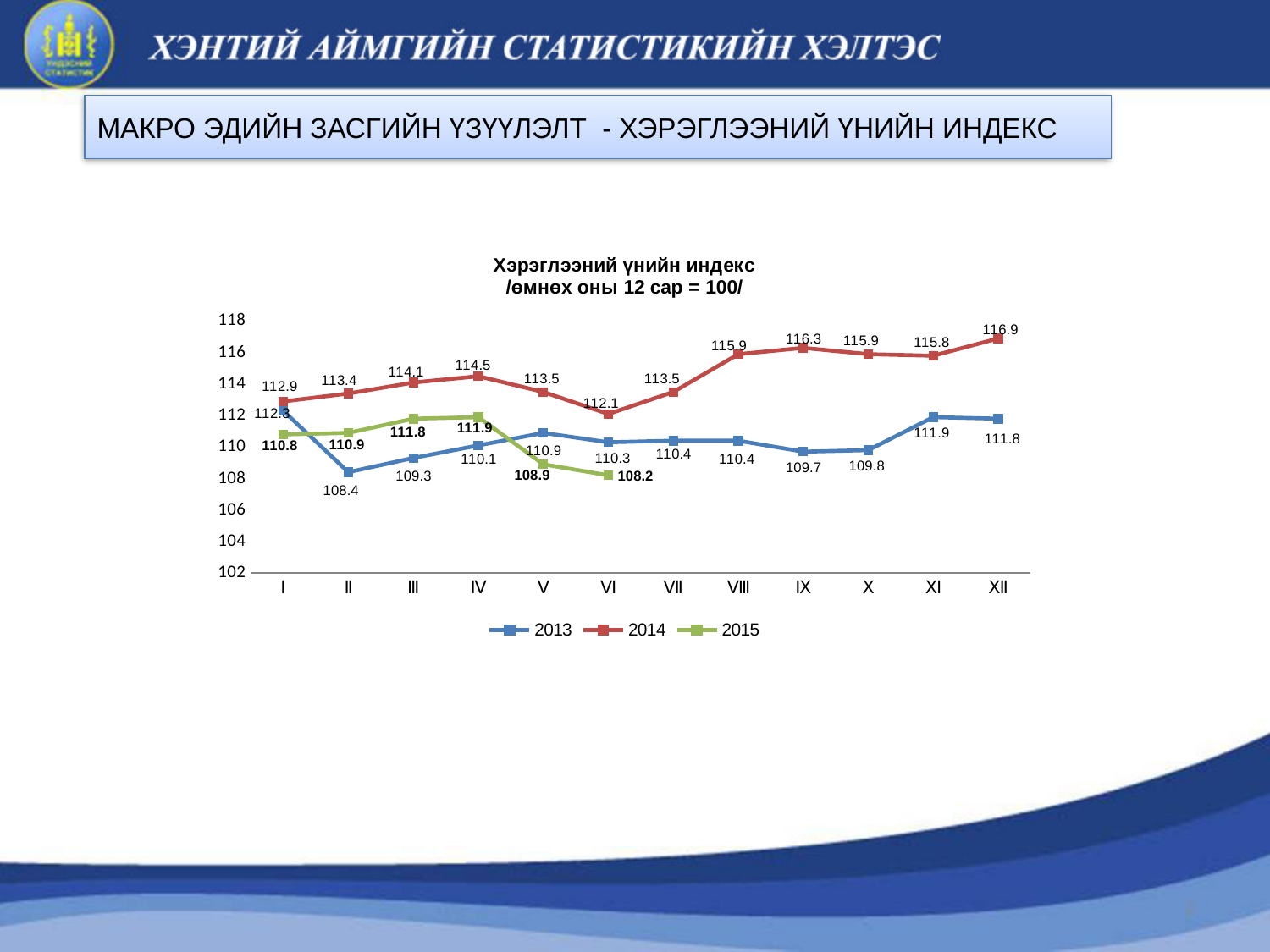
How many series does the legend list? 3 Which is larger in month IV: the 2014 value or the 2015 value? 2014 What is the value for 2015 in month VI? 108.2 What is the value for 2014 in month XII? 116.9 Does the 2014 series rise or fall from month VI to month IX? rise What type of chart is shown on the slide? line chart In which month does the 2013 series have its lowest value? II What is the value for 2013 in month II? 108.4 What is the title of the chart? Хэрэглээний үнийн индекс /өмнөх оны 12 сар = 100/ In which month does the 2014 series reach its highest value? XII How many months are plotted for the 2015 series? 6 What is the difference between the 2014 and 2013 values in month XII? 5.1